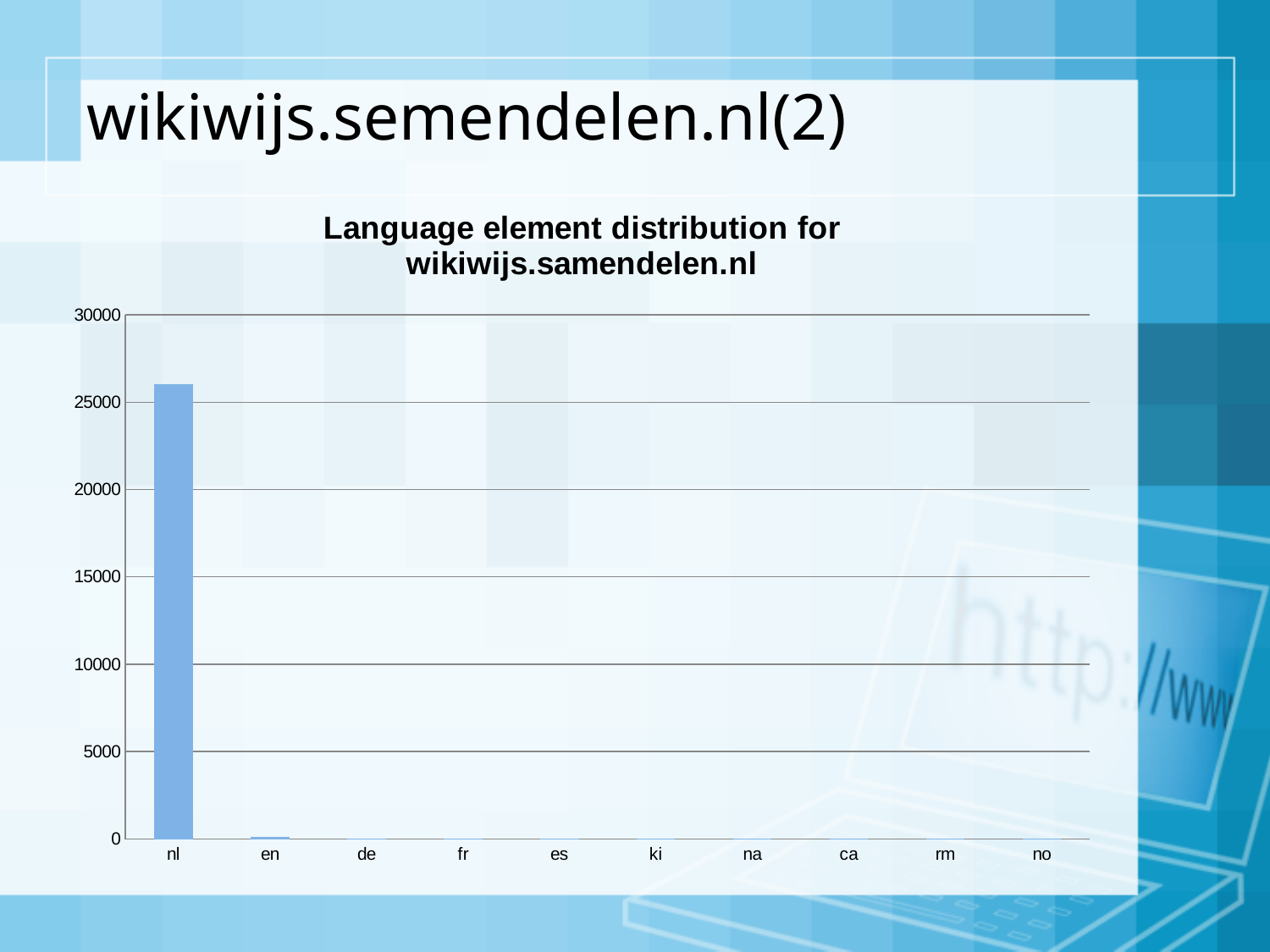
What kind of chart is shown on the slide? bar chart Which language is listed first on the x axis? nl Which is larger, the value for nl or the value for en? nl Is the value for nl greater or less than 20000? greater What is the title of the chart? Language element distribution for wikiwijs.samendelen.nl Is the value for de greater or less than 5000? less Is the value for en greater or less than 5000? less What is the highest value shown on the y axis? 30000 Which language has the highest value? nl How many language categories are shown on the x axis? 10